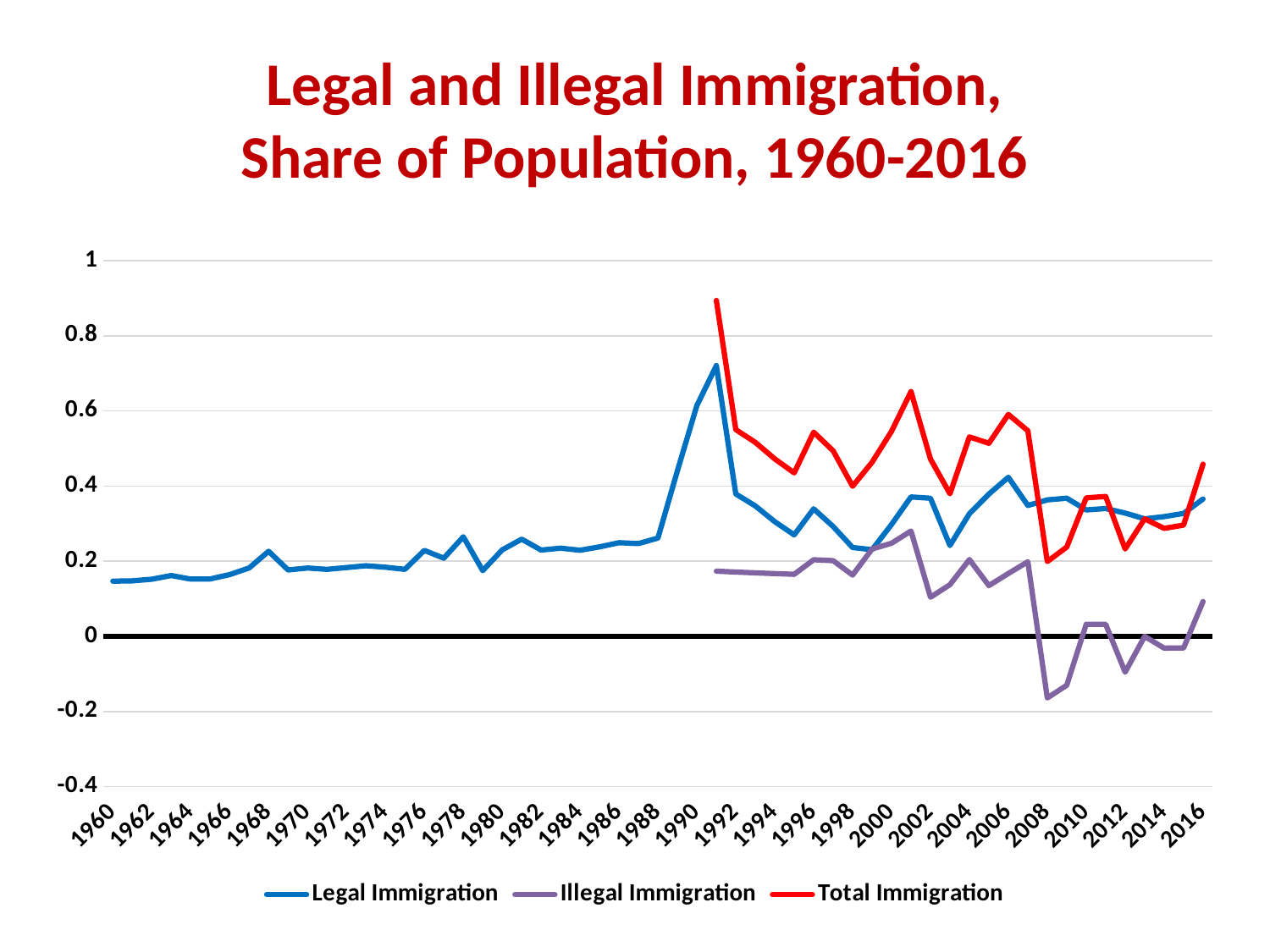
Is the value for Total Immigration in 2008 greater or less than 0.4? less Is the value for Legal Immigration in 1960 greater or less than 0.2? less Which series reaches the highest value anywhere on the chart? Total Immigration Does Legal Immigration rise or fall between 1960 and 1968? rise What colour is the Total Immigration line? red What kind of chart is shown on the slide? line chart In 2008, which is larger: Legal Immigration or Illegal Immigration? Legal Immigration How many series does the legend list? 3 In 2016, which is larger: Total Immigration or Illegal Immigration? Total Immigration Is the value for Legal Immigration in 2016 greater or less than 0.2? greater Which series drops to the lowest value anywhere on the chart? Illegal Immigration